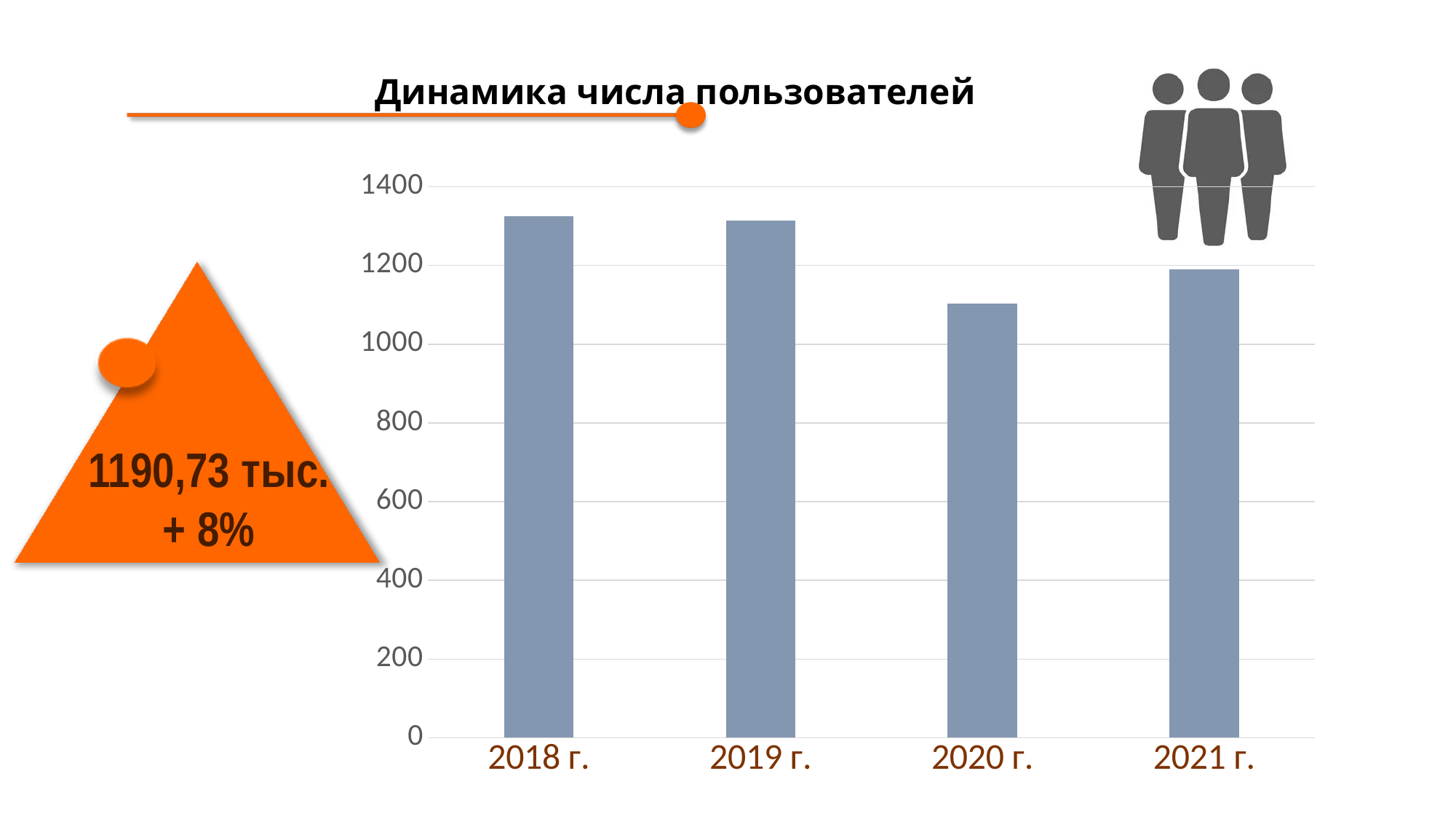
Which year has the lowest bar in the chart? 2020 г. What is the highest value shown on the vertical axis of the chart? 1400 Is the value for 2021 г. greater or less than 1000? greater Which is larger, the value for 2020 г. or the value for 2021 г.? 2021 г. Which is larger, the value for 2018 г. or the value for 2020 г.? 2018 г. How many years are shown on the x axis of the chart? 4 What kind of chart is shown on the slide? bar chart Is the value for 2020 г. greater or less than 1000? greater Is the value for 2018 г. greater or less than 1200? greater What is the title of the chart? Динамика числа пользователей Do the values fall or rise from 2018 г. to 2020 г.? fall